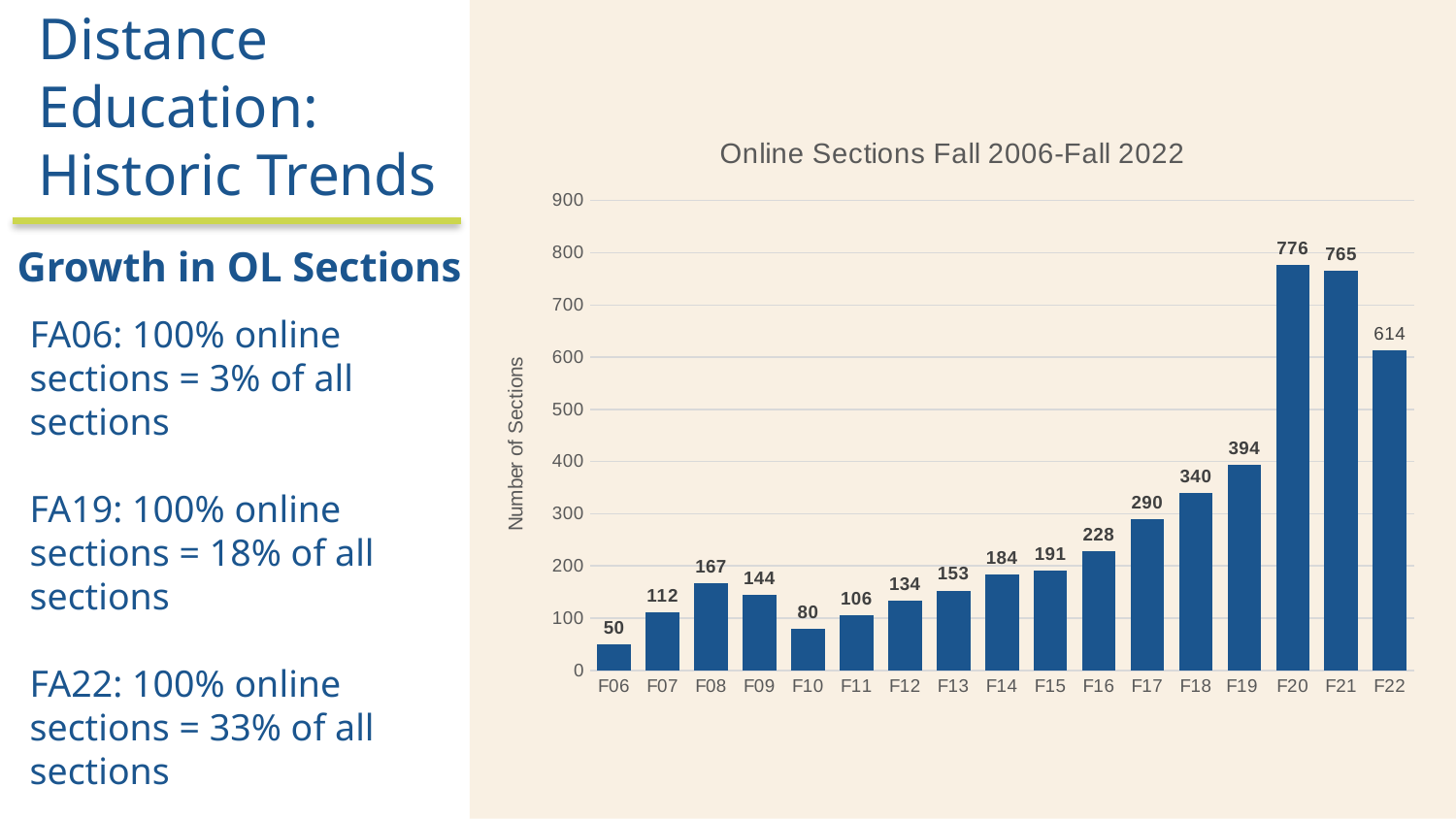
Which year has the highest number of online sections? F20 What is the number of online sections for F06? 50 What is the number of online sections for F20? 776 What is the difference in online sections between F19 and F18? 54 Which has more online sections, F08 or F09? F08 What is the difference in online sections between F20 and F21? 11 How many years (bars) are shown in the chart? 17 Is the value for F17 greater or less than 300? less Which year has the lowest number of online sections? F06 What is the title of the chart? Online Sections Fall 2006-Fall 2022 What is the number of online sections for F22? 614 What type of chart is shown on the slide? Bar chart